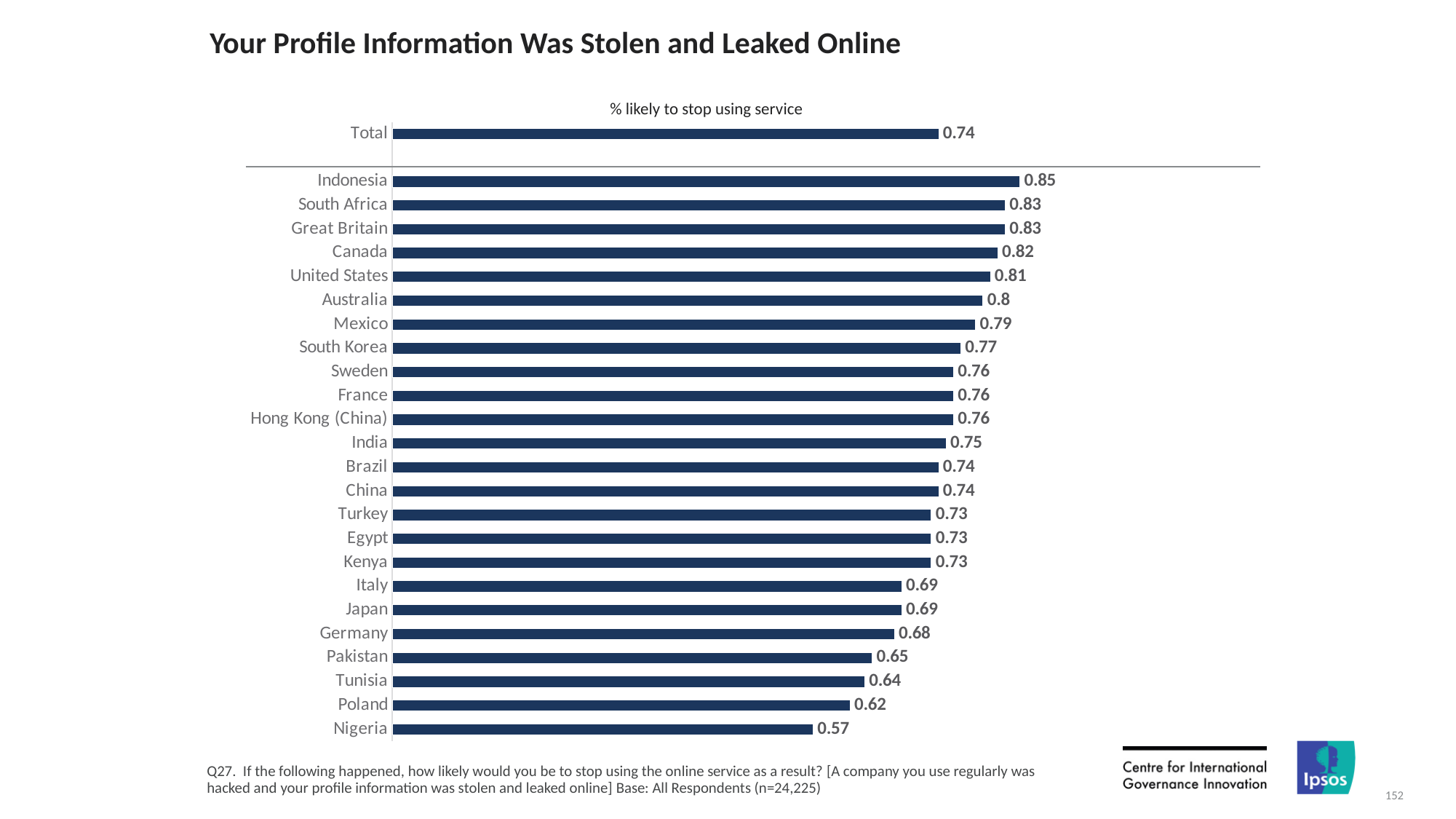
What is the value for Nigeria? 0.57 Which country has the lowest value? Nigeria What is the difference between the values for Canada and Poland? 0.2 Which has a larger value, Mexico or Pakistan? Mexico What is the value for Indonesia? 0.85 How many countries (excluding Total) are shown in the chart? 24 What is the value for Total? 0.74 What is the subtitle shown above the chart bars? % likely to stop using service Which country has the highest value? Indonesia What is the difference between the values for Indonesia and Nigeria? 0.28 What is the value for Germany? 0.68 What kind of chart is shown on the slide? Bar chart